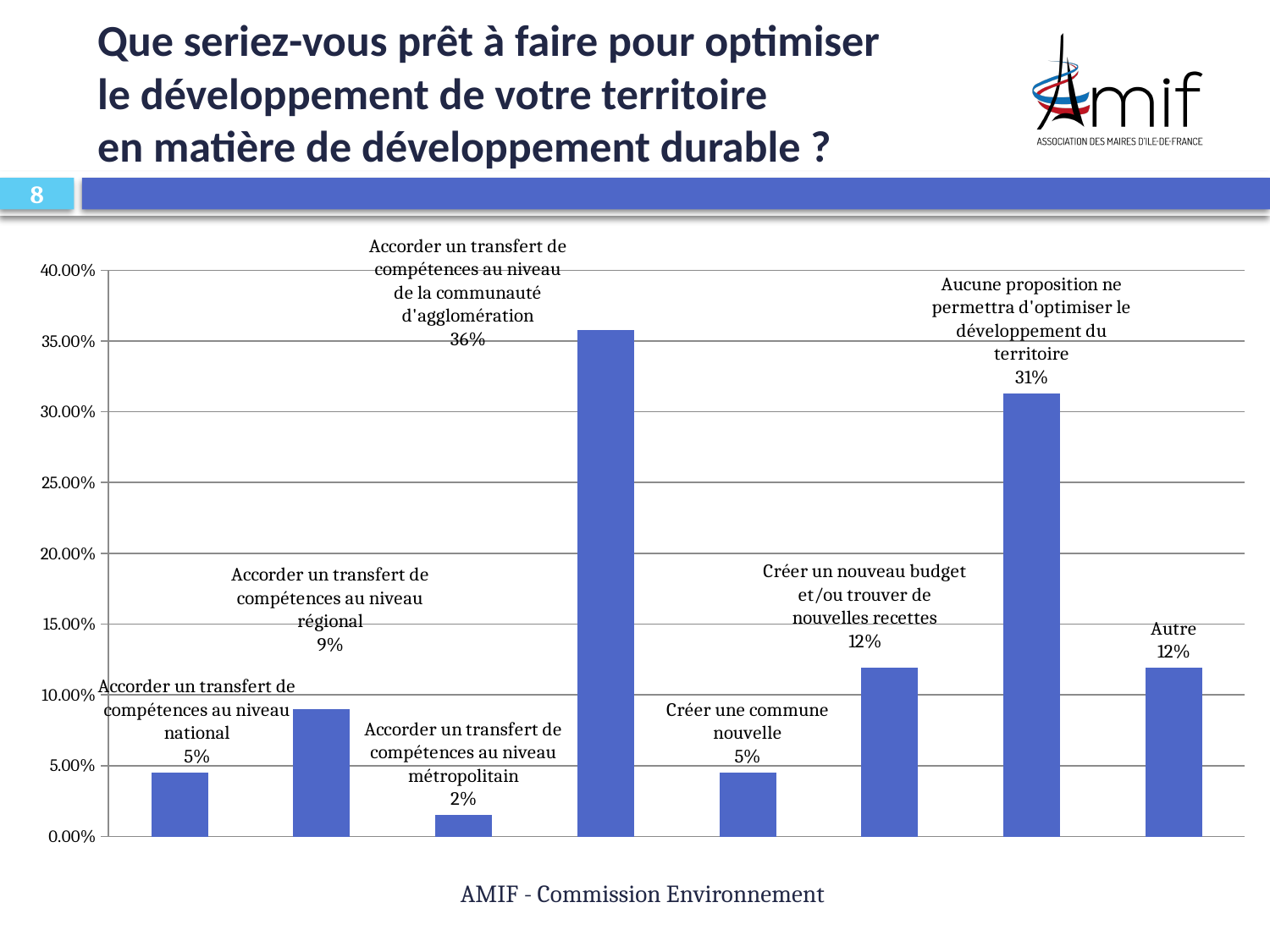
Which category has the lowest value in the chart? Accorder un transfert de compétences au niveau métropolitain Which category has the highest value in the chart? Accorder un transfert de compétences au niveau de la communauté d'agglomération What is the value shown for "Autre"? 12% What is the value for "Créer un nouveau budget et/ou trouver de nouvelles recettes"? 12% What is the value shown for "Aucune proposition ne permettra d'optimiser le développement du territoire"? 31% What percentage of respondents chose "Accorder un transfert de compétences au niveau de la communauté d'agglomération"? 36% Which is larger: the value for "Accorder un transfert de compétences au niveau régional" or the value for "Accorder un transfert de compétences au niveau national"? Accorder un transfert de compétences au niveau régional What is the difference between the value for "Accorder un transfert de compétences au niveau de la communauté d'agglomération" and the value for "Aucune proposition ne permettra d'optimiser le développement du territoire"? 5% Is the value for "Aucune proposition ne permettra d'optimiser le développement du territoire" greater or less than 30.00%? greater How many categories (bars) are shown in the chart? 8 What percentage is shown for "Accorder un transfert de compétences au niveau métropolitain"? 2% What type of chart is shown on the slide? Bar chart